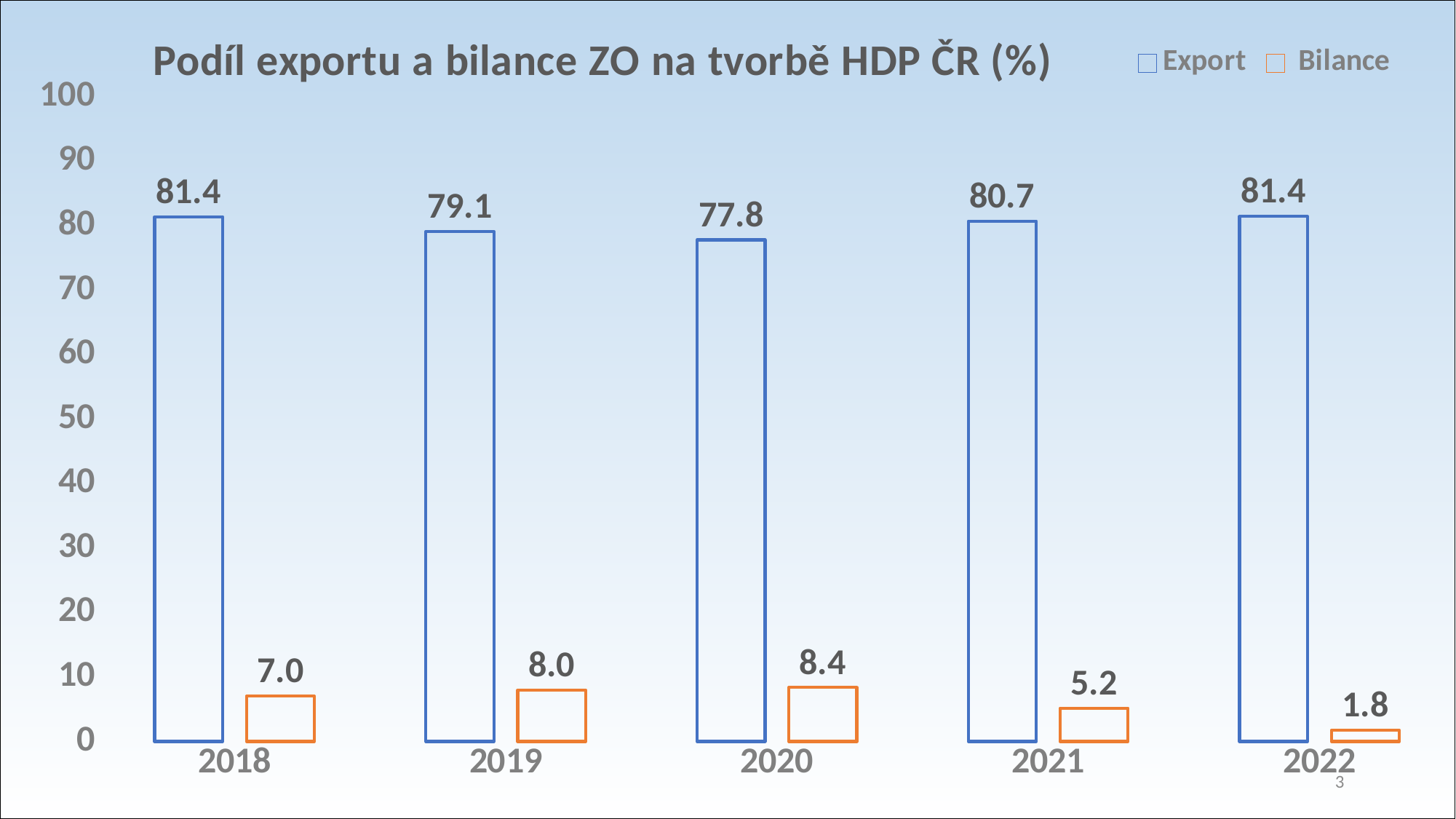
What is the Export value for 2020? 77.8 What kind of chart is shown on the slide? bar chart What is the difference between the Bilance values for 2020 and 2022? 6.6 What is the Export value for 2019? 79.1 Does the Bilance value rise or fall from 2020 to 2022? fall What is the Bilance value for 2021? 5.2 Which year has the lowest Bilance value? 2022 Which year has the lowest Export value? 2020 How many series does the legend list? 2 Which is larger, the Export value for 2021 or the Export value for 2019? 2021 Which year has the highest Bilance value? 2020 How many years are shown on the x axis? 5